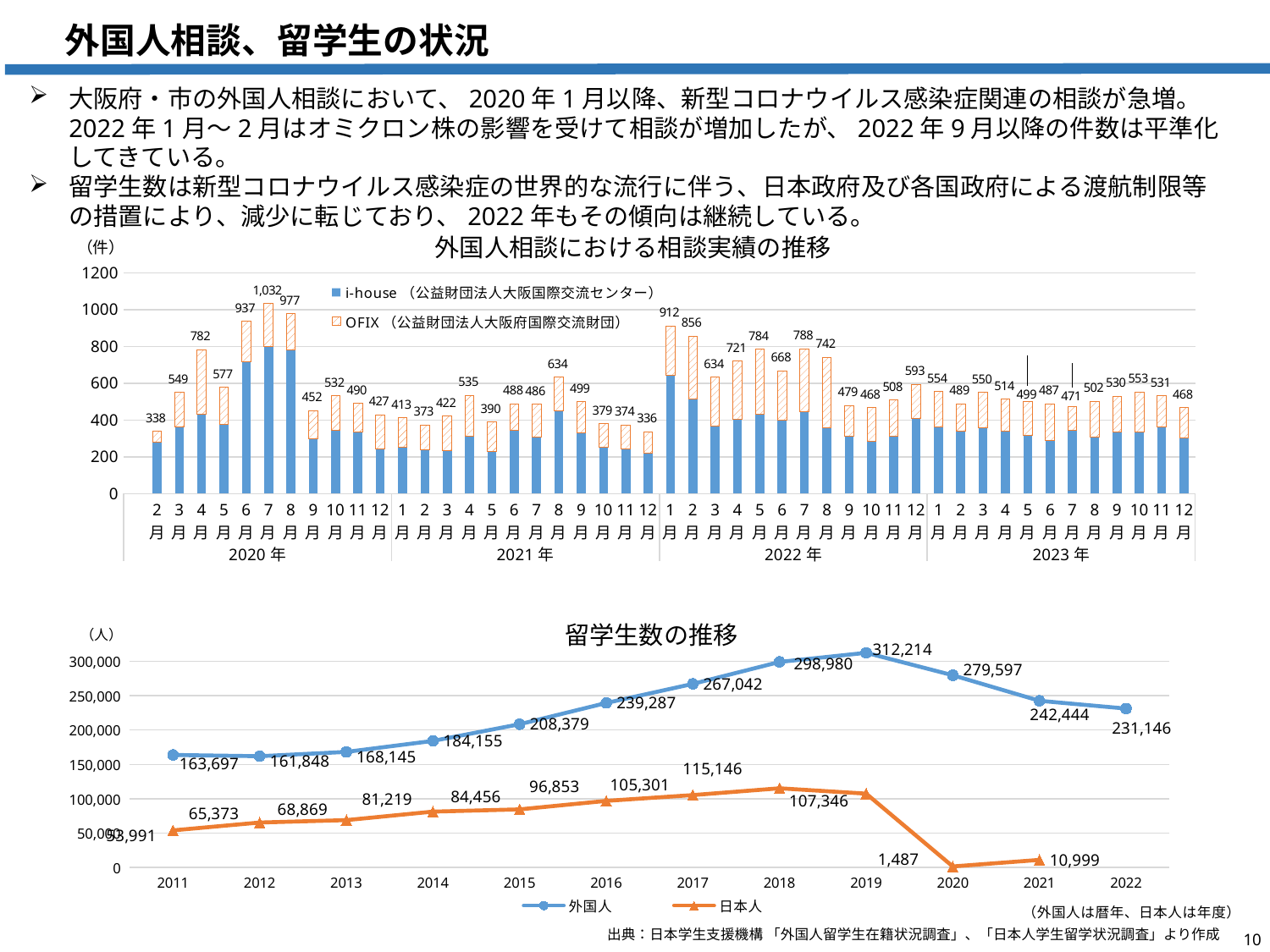
In the top chart 外国人相談における相談実績の推移, what is the total for 2023年12月? 468 In the bottom chart 留学生数の推移, which year has the highest value for 外国人? 2019 In the bottom chart 留学生数の推移, what is the difference between the 外国人 values for 2019 and 2022? 81,068 In the bottom chart 留学生数の推移, what is the value for 外国人 in 2019? 312,214 In the top chart 外国人相談における相談実績の推移, which is larger: the total for 2020年7月 or the total for 2022年1月? 2020年7月 In the top chart 外国人相談における相談実績の推移, which month has the highest total? 2020年7月 What kind of chart is the bottom chart titled 留学生数の推移? Line chart In the top chart 外国人相談における相談実績の推移, how many series does the legend list? 2 In the bottom chart 留学生数の推移, what is the value for 日本人 in 2020? 1,487 In the bottom chart 留学生数の推移, how many data points are plotted for 外国人? 12 In the bottom chart 留学生数の推移, do the 外国人 values rise or fall from 2019 to 2022? Fall In the top chart 外国人相談における相談実績の推移, what is the total for 2022年1月? 912